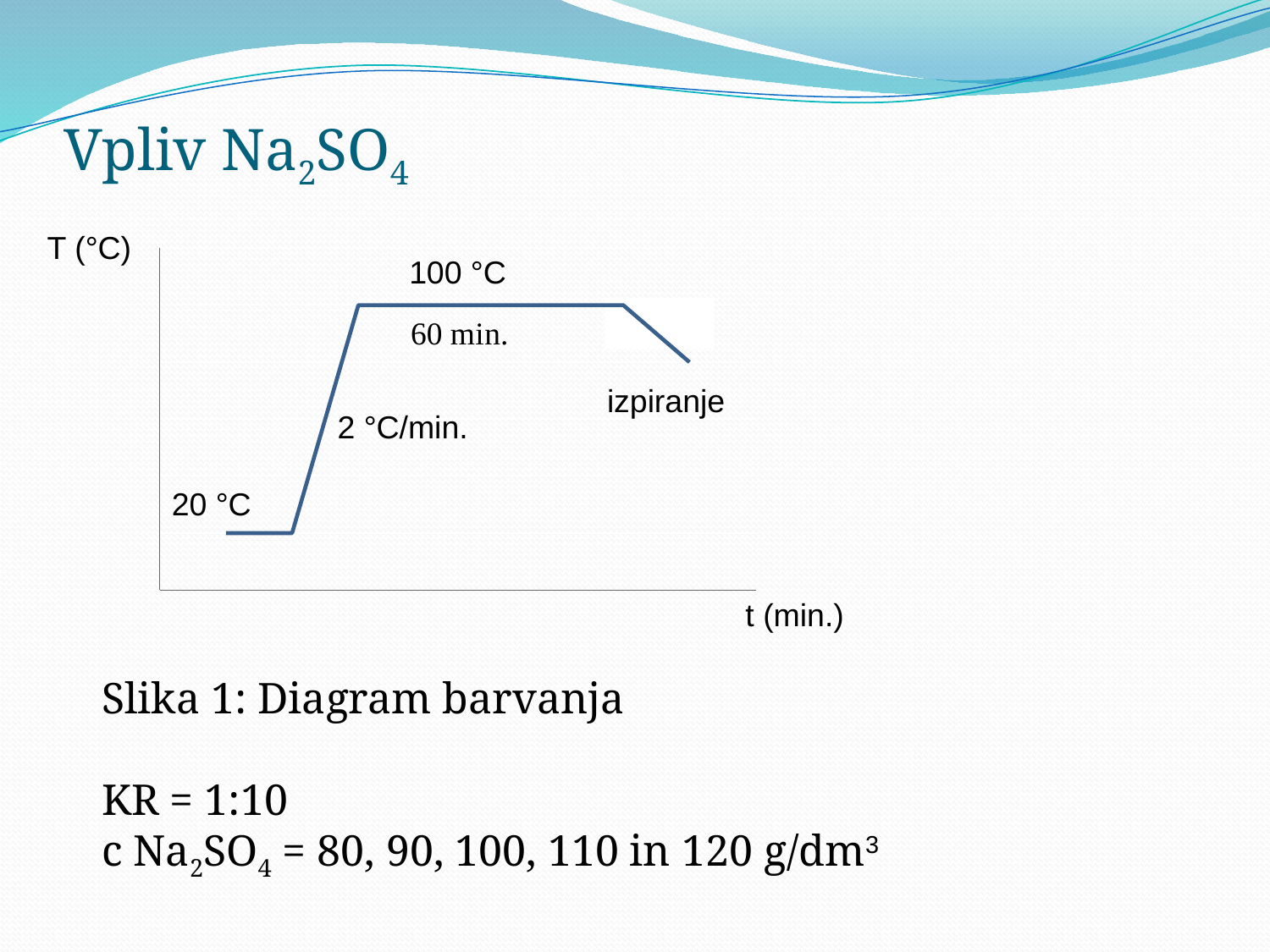
What is the difference between the maximum temperature and the starting temperature in the diagram? 80 °C What is the lowest temperature labelled on the diagram? 20 °C Which is higher, the starting temperature or the plateau temperature in the diagram? the plateau temperature (100 °C) What is the starting temperature shown on the dyeing diagram? 20 °C What label is given to the final falling segment of the diagram? izpiranje What is the label of the vertical axis of the diagram? T (°C) How does the temperature change along the time axis in the diagram? rises, stays constant, then falls What is the maximum temperature reached in the diagram? 100 °C What heating rate is labelled on the rising segment of the diagram? 2 °C/min. What kind of chart is shown on the slide? line chart How long is the temperature held at 100 °C according to the diagram? 60 min.